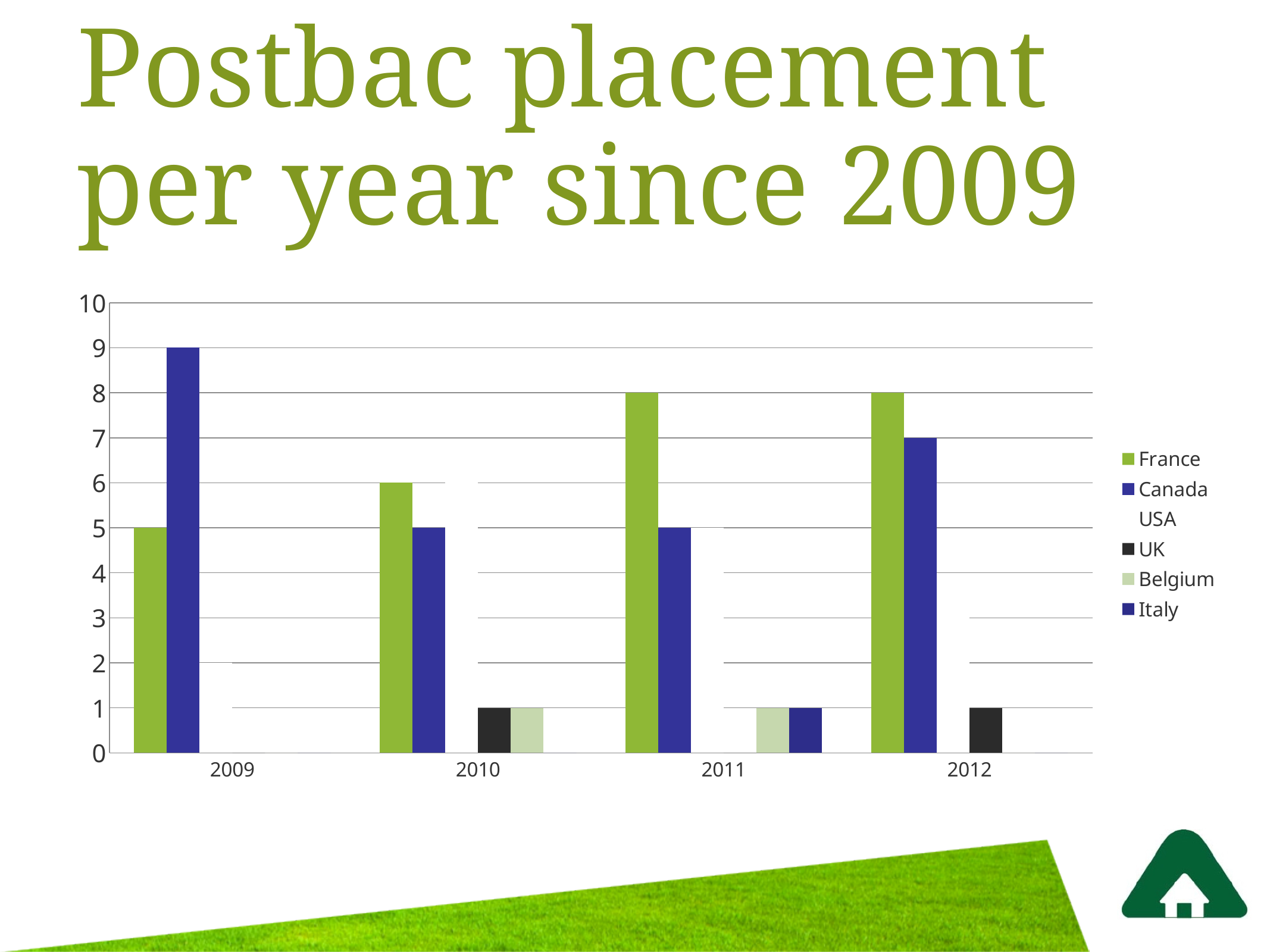
In which year is the France value lowest? 2009 How many years are shown on the x axis? 4 What kind of chart is shown on the slide? Bar chart How many series does the legend list? 6 What is the title of the slide? Postbac placement per year since 2009 What is the value for Canada in 2012? 7 In which year is the Canada value highest? 2009 What is the value for Canada in 2009? 9 Which is larger in 2009, the France value or the Canada value? Canada What is the difference between the France and Canada values in 2011? 3 What is the value for France in 2011? 8 What is the value for France in 2010? 6